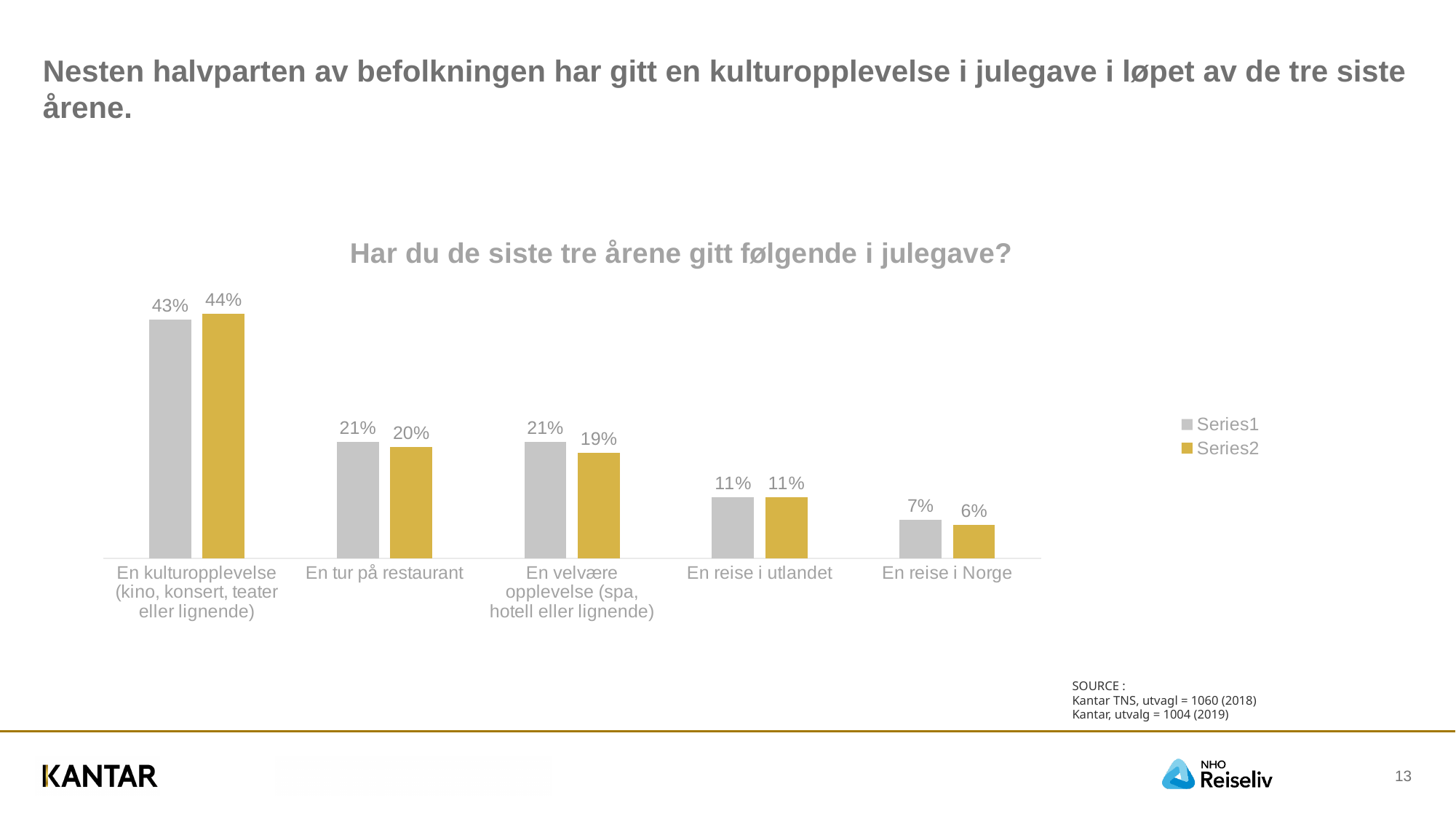
How many series does the legend list? 2 Which is larger for "En kulturopplevelse": the Series1 value or the Series2 value? Series2 What is the title of the chart? Har du de siste tre årene gitt følgende i julegave? Do the Series1 values rise or fall from left to right across the categories? Fall What is the Series1 value for "En kulturopplevelse (kino, konsert, teater eller lignende)"? 43% What is the difference between the Series1 and Series2 values for "En velvære opplevelse (spa, hotell eller lignende)"? 2% How many categories are shown on the x axis? 5 Which category has the highest Series2 value? En kulturopplevelse (kino, konsert, teater eller lignende) What kind of chart is shown on the slide? Bar chart What is the Series2 value for "En tur på restaurant"? 20% What is the Series2 value for "En reise i Norge"? 6% Which category has the lowest Series1 value? En reise i Norge